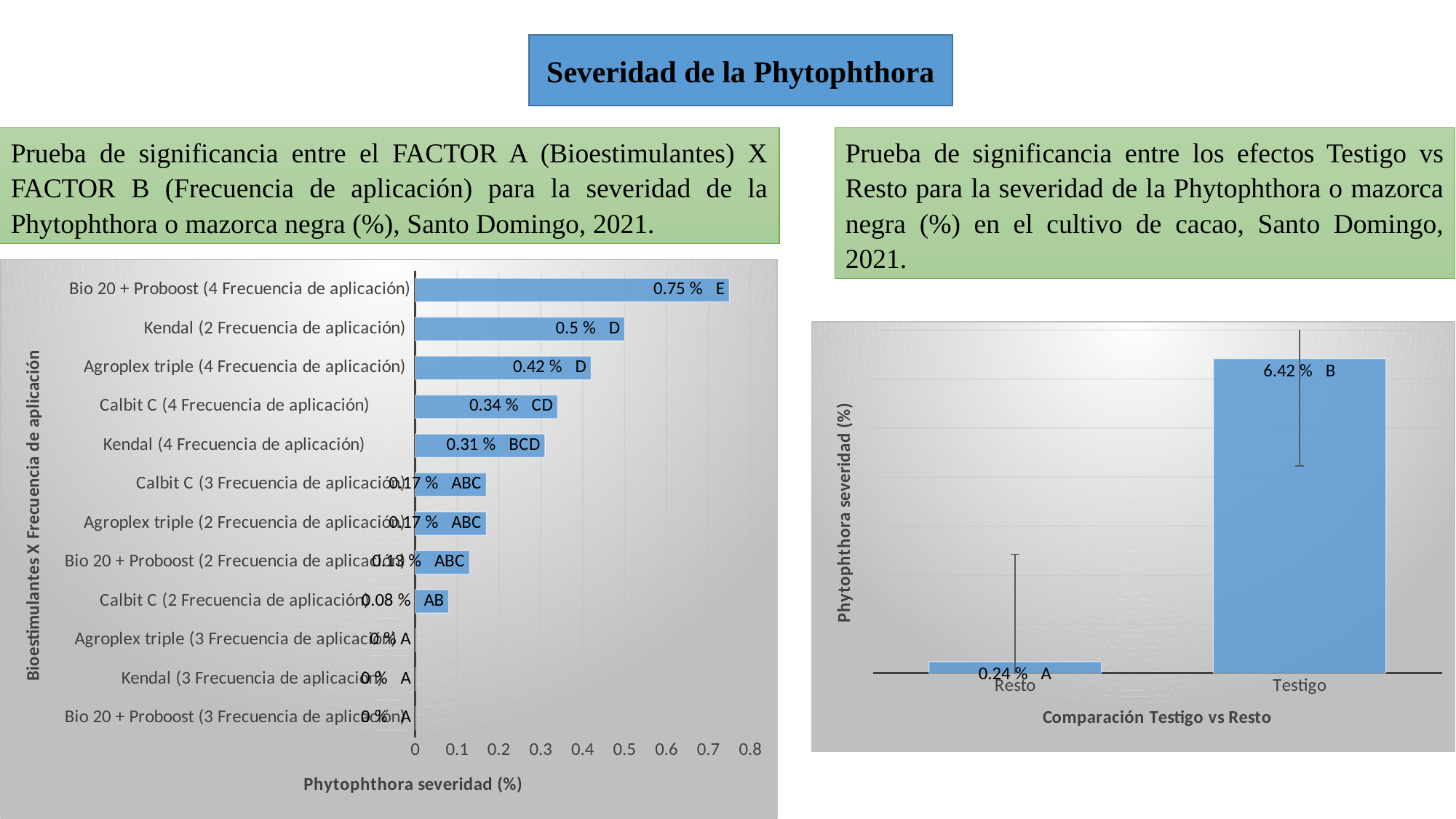
On the right chart, what is the Phytophthora severity value for Testigo? 6.42 % On the right chart, what is the difference between the Testigo and Resto values? 6.18 % On the left chart, what is the value shown for Kendal (2 Frecuencia de aplicación)? 0.5 % On the left chart, how many treatment categories are plotted? 12 On the right chart, what is the Phytophthora severity value for Resto? 0.24 % On the left chart, what kind of chart is shown? Bar chart On the left chart, which is larger: the value for Kendal (4 Frecuencia de aplicación) or Calbit C (2 Frecuencia de aplicación)? Kendal (4 Frecuencia de aplicación) On the left chart, what is the value shown for Calbit C (4 Frecuencia de aplicación)? 0.34 % On the left chart, what is the label of the horizontal axis? Phytophthora severidad (%) On the left chart, what is the Phytophthora severity value for Bio 20 + Proboost (4 Frecuencia de aplicación)? 0.75 % On the left chart, which treatment has the highest Phytophthora severity? Bio 20 + Proboost (4 Frecuencia de aplicación) On the left chart, what is the difference between the values for Kendal (2 Frecuencia de aplicación) and Agroplex triple (4 Frecuencia de aplicación)? 0.08 %